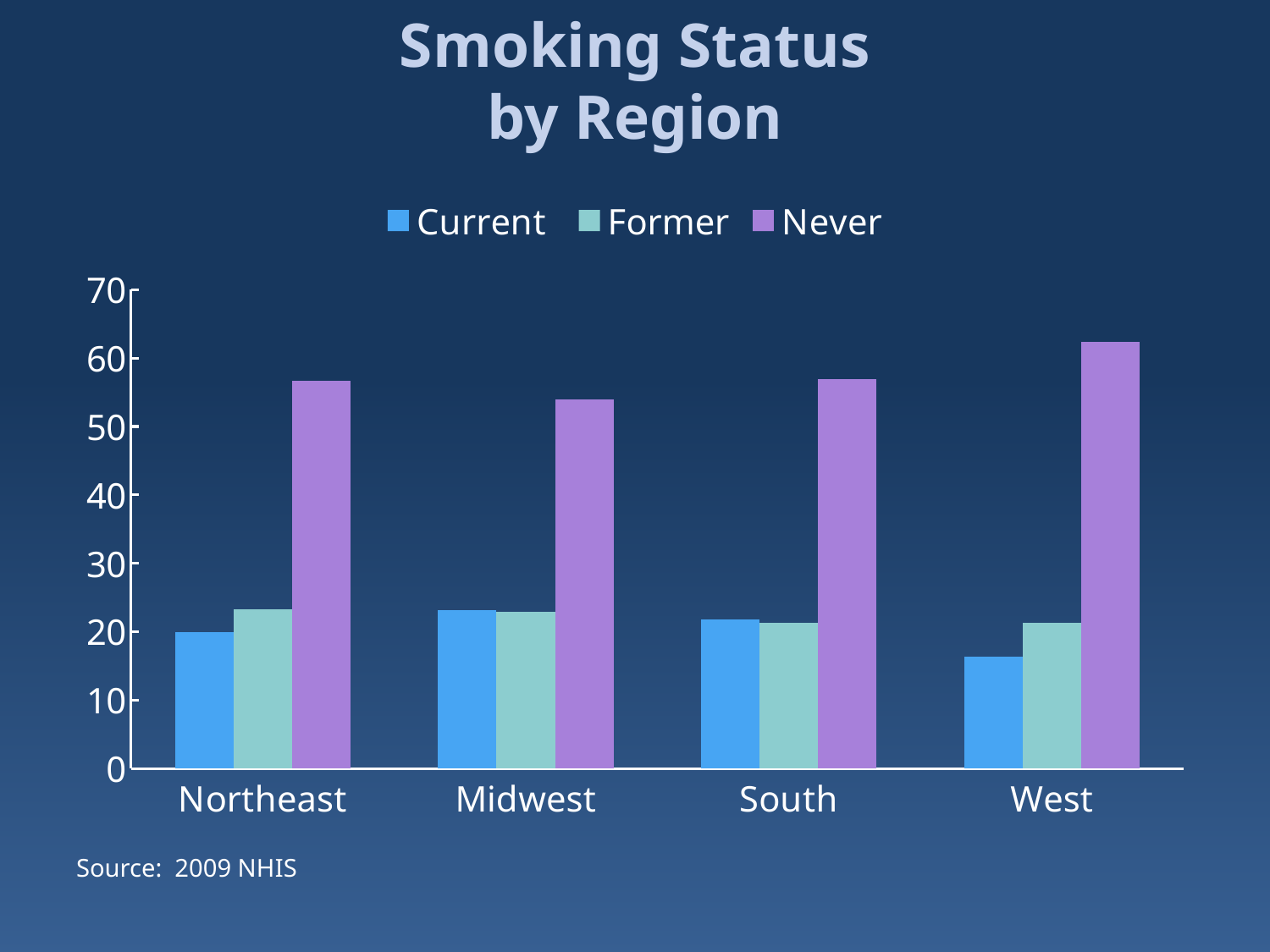
How many regions are shown on the x axis? 4 What kind of chart is shown on the slide? bar chart Is the value for Former in the South greater or less than 30? less What is the title of the chart? Smoking Status by Region Which region has the highest value for Never? West In the West, which is larger, the Current value or the Former value? Former Which is larger, the Never value for the Northeast or the Never value for the Midwest? Northeast Is the value for Current in the West greater or less than 20? less Which region has the lowest value for Current? West Which region has the lowest value for Never? Midwest Is the value for Never in the Northeast greater or less than 50? greater How many series does the legend list? 3